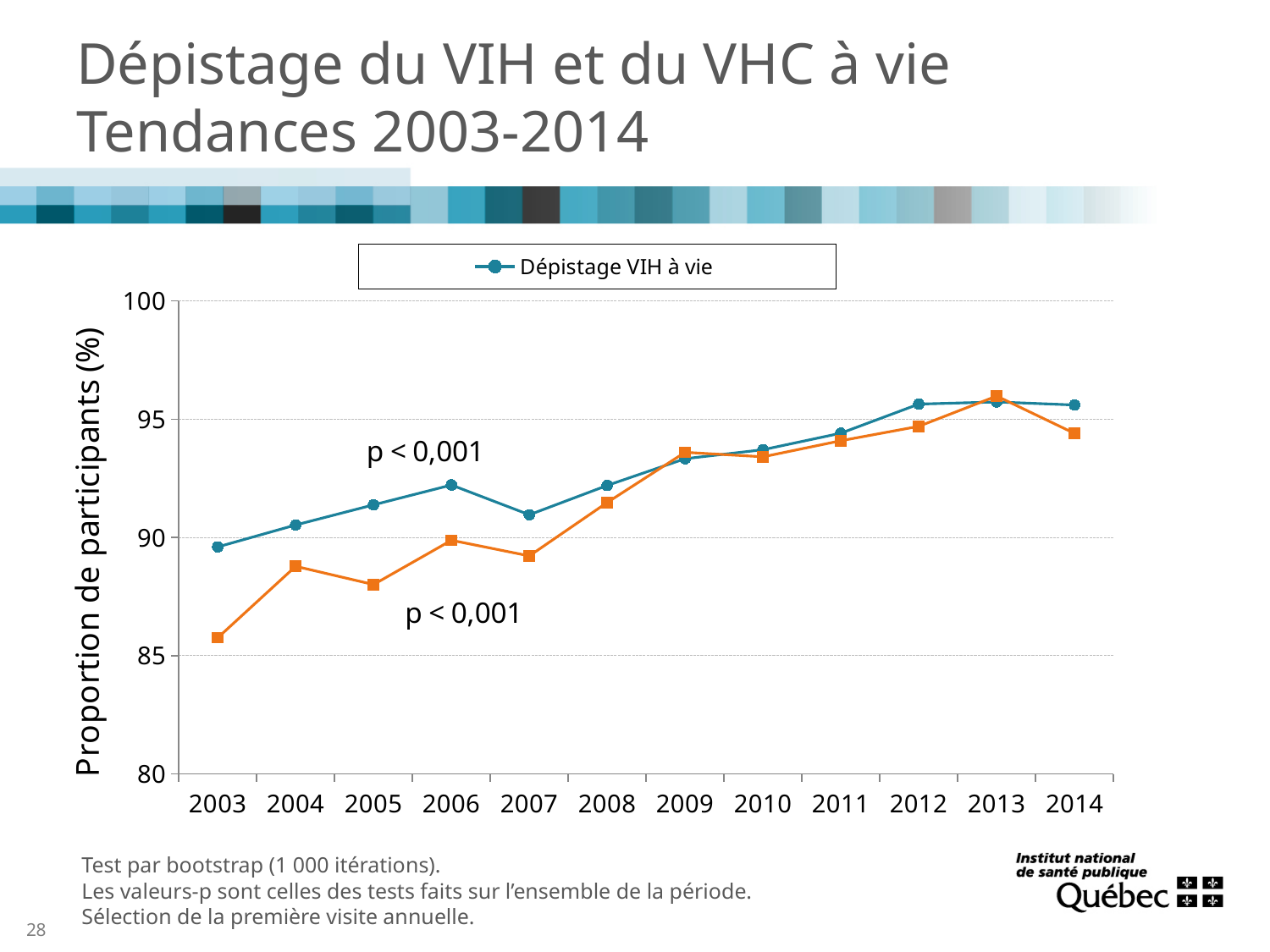
In which year is the Dépistage VIH à vie series at its lowest value? 2003 Overall, do the values of the Dépistage VIH à vie series rise or fall from 2003 to 2014? rise Is the value for Dépistage VIH à vie in 2003 greater or less than 90? less How many series does the chart's legend list? 1 Is the value of the orange square series in 2003 greater or less than 85? greater What kind of chart is shown on the slide? line chart How many years are shown along the x axis of the chart? 12 Is the value of the orange square series in 2014 greater or less than 95? less In 2005, which series has the higher value: the blue circle series (Dépistage VIH à vie) or the orange square series? Dépistage VIH à vie (blue circle series) What is the title of the y axis of the chart? Proportion de participants (%) What series name appears in the chart's legend? Dépistage VIH à vie